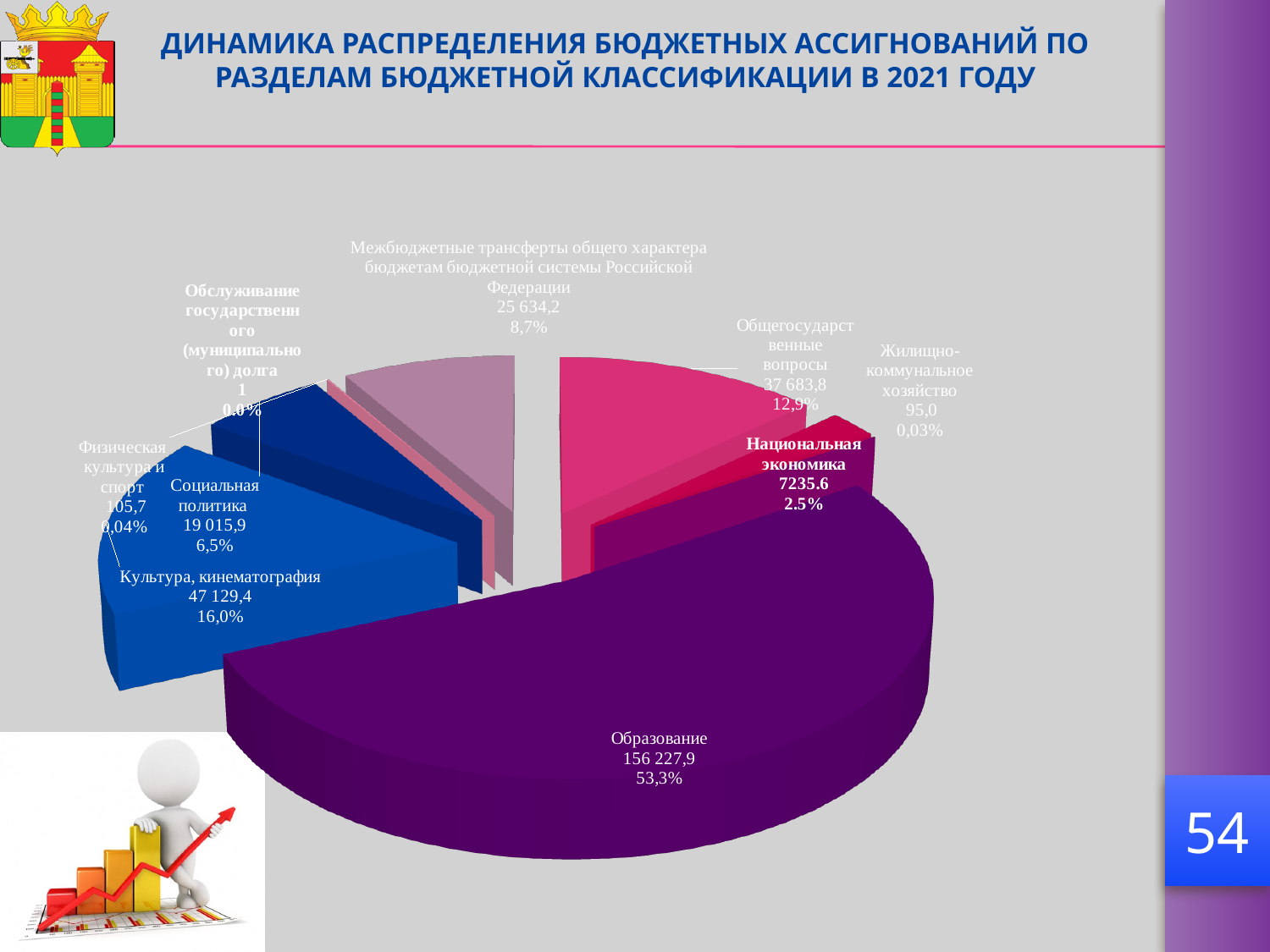
What percentage is shown for Межбюджетные трансферты общего характера бюджетам бюджетной системы Российской Федерации? 8,7% What value is shown for Образование? 156 227,9 What share of the pie does Образование account for? 53,3% What value is shown for Социальная политика? 19 015,9 Which is larger: Культура, кинематография or Социальная политика? Культура, кинематография What percentage is shown for Общегосударственные вопросы? 12,9% What kind of chart is shown on the slide? pie chart Which section has the smallest value? Обслуживание государственного (муниципального) долга Which section has the largest share of the pie? Образование What value is shown for Культура, кинематография? 47 129,4 How many sections (slices) does the pie chart show? 9 What is the difference between the values for Образование and Культура, кинематография? 109 098,5